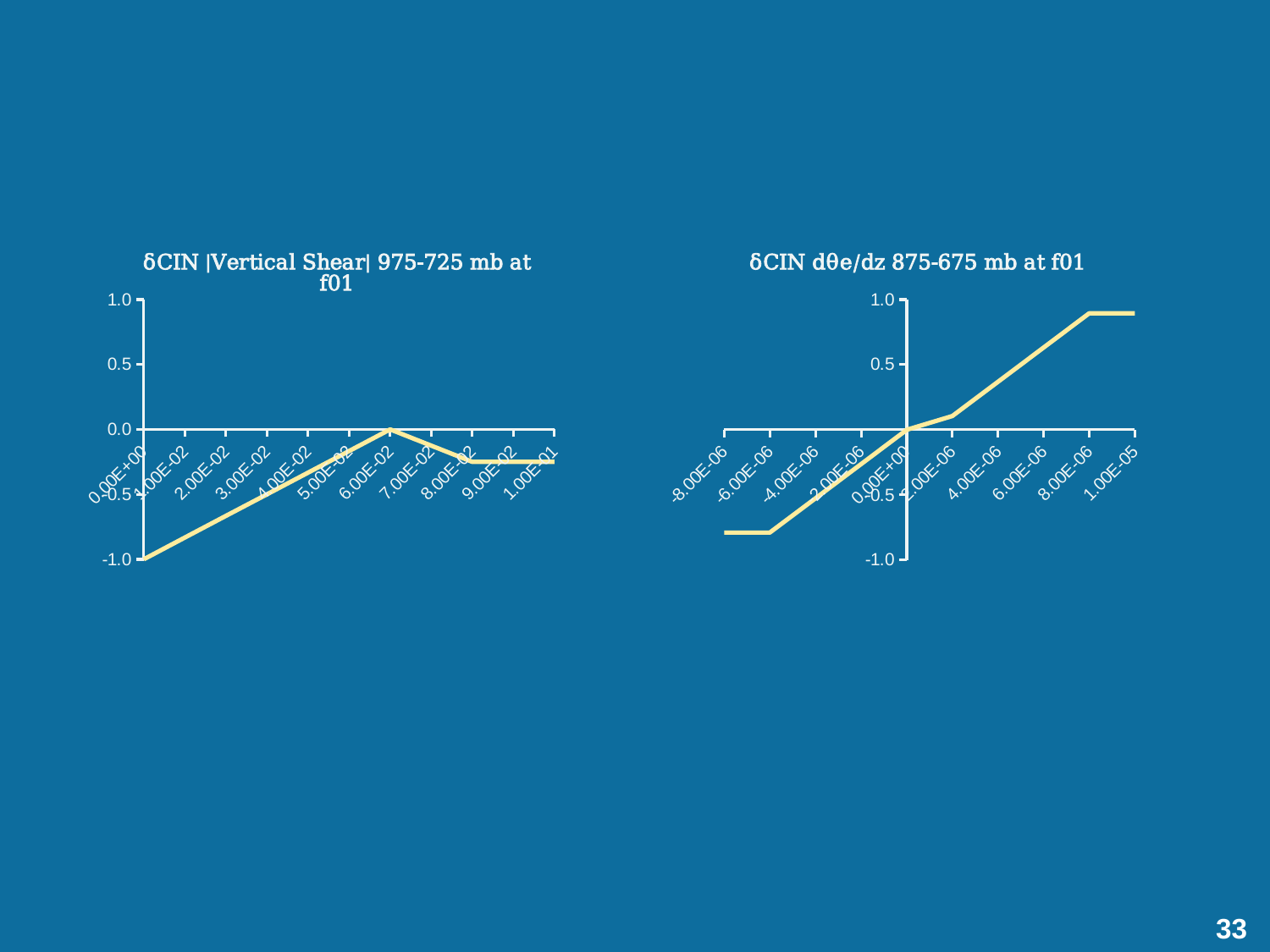
In the chart titled "δCIN |Vertical Shear| 975-725 mb at f01", what is the value at 0.00E+00? -1.0 What kind of chart is the chart titled "δCIN dθe/dz 875-675 mb at f01"? line chart In the chart titled "δCIN dθe/dz 875-675 mb at f01", is the value at -8.00E-06 greater or less than -0.5? less In the chart titled "δCIN |Vertical Shear| 975-725 mb at f01", is the value at 1.00E-01 greater or less than 0.0? less In the chart titled "δCIN |Vertical Shear| 975-725 mb at f01", which is larger, the value at 0.00E+00 or the value at 6.00E-02? 6.00E-02 In the chart titled "δCIN |Vertical Shear| 975-725 mb at f01", what is the value at 6.00E-02? 0.0 In the chart titled "δCIN dθe/dz 875-675 mb at f01", is the value at 1.00E-05 greater or less than 0.5? greater What kind of chart is the chart titled "δCIN |Vertical Shear| 975-725 mb at f01"? line chart What is the title of the chart on the right side of the slide? δCIN dθe/dz 875-675 mb at f01 In the chart titled "δCIN dθe/dz 875-675 mb at f01", do the values generally rise or fall from left to right along the x axis? rise In the chart titled "δCIN |Vertical Shear| 975-725 mb at f01", do the values rise or fall between 0.00E+00 and 6.00E-02? rise In the chart titled "δCIN dθe/dz 875-675 mb at f01", what is the value at 0.00E+00? 0.0